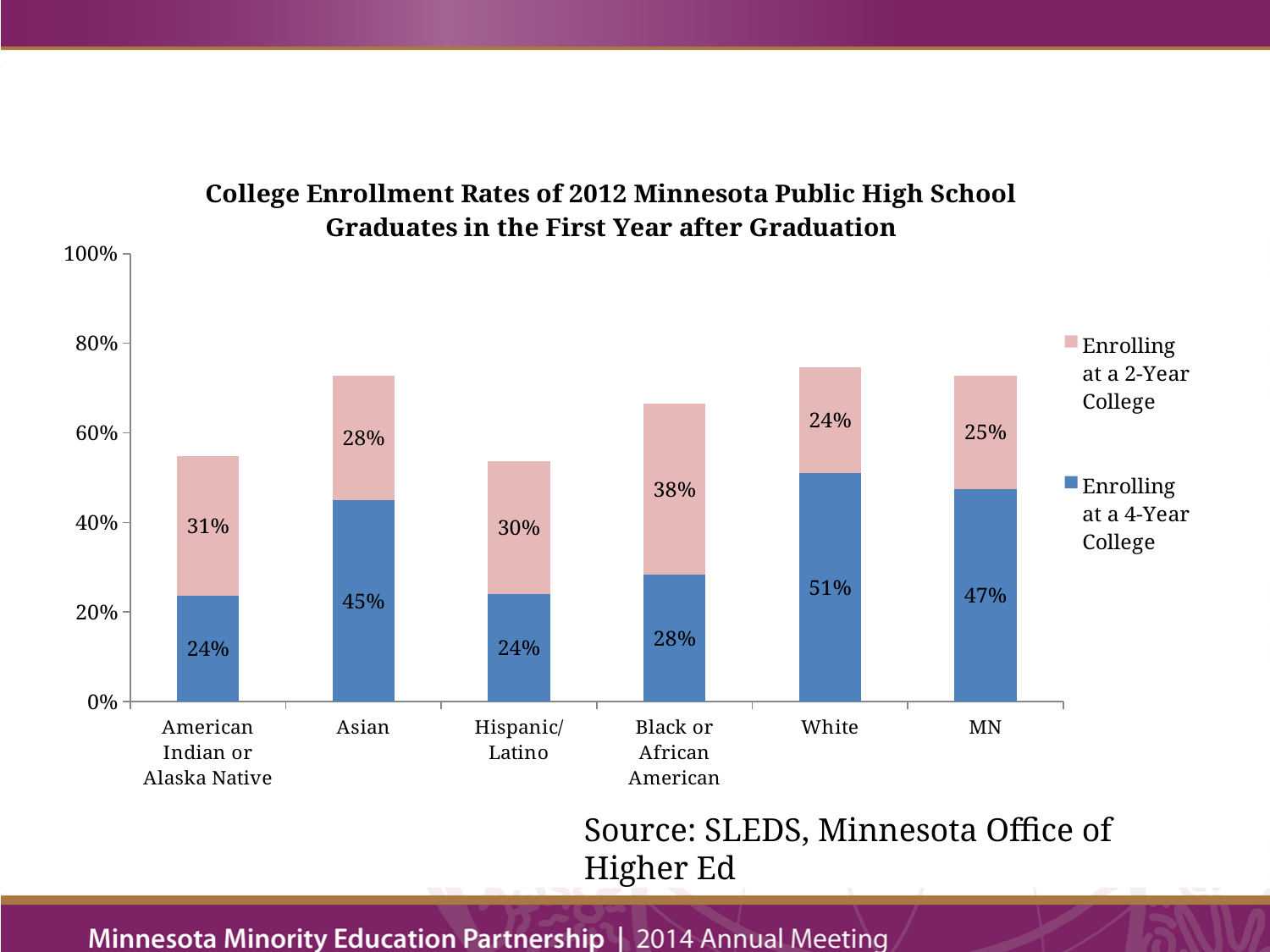
Which group has the highest rate of enrolling at a 4-year college? White What percentage of Asian graduates enrolled at a 4-year college? 45% How many series does the legend list? 2 How many groups are shown on the x axis? 6 What is the value for MN for enrolling at a 4-year college? 47% Which group has the lowest rate of enrolling at a 2-year college? White Which group has the highest rate of enrolling at a 2-year college? Black or African American What is the total college enrollment rate (2-year plus 4-year) for Black or African American graduates? 66% What is the difference between the 4-year college enrollment rates of White and Hispanic/Latino graduates? 27% What percentage of Black or African American graduates enrolled at a 2-year college? 38% Which is larger: the 2-year college enrollment rate for American Indian or Alaska Native graduates or for Asian graduates? American Indian or Alaska Native What kind of chart is shown on the slide? Stacked bar chart